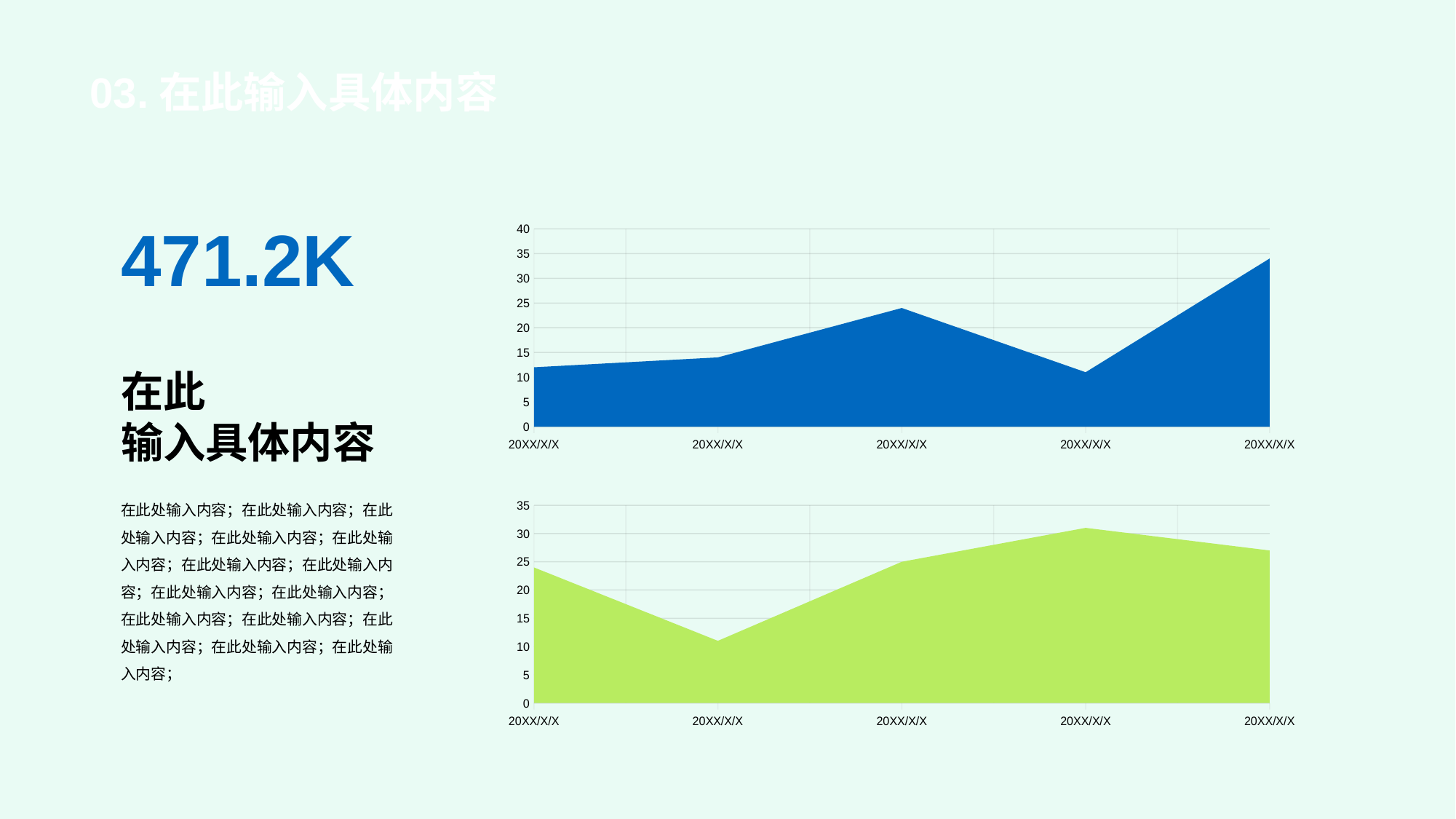
In the bottom chart, do the values rise or fall from the second point to the fourth point? rise In the top chart, how many data points are plotted along the x axis? 5 In the bottom chart, is the value of the second point greater or less than 15? less In the top chart, which point has the highest value? the last (fifth) point In the top chart, which is larger: the value of the third point or the value of the fifth point? the fifth point In the top chart, is the value of the fourth point greater or less than 15? less In the bottom chart, which point has the lowest value? the second point In the bottom chart, which point has the highest value? the fourth point What kind of chart is the bottom chart on the slide? area chart What kind of chart is the top chart on the slide? area chart In the bottom chart, how many data points are plotted along the x axis? 5 In the top chart, is the value of the last point greater or less than 30? greater